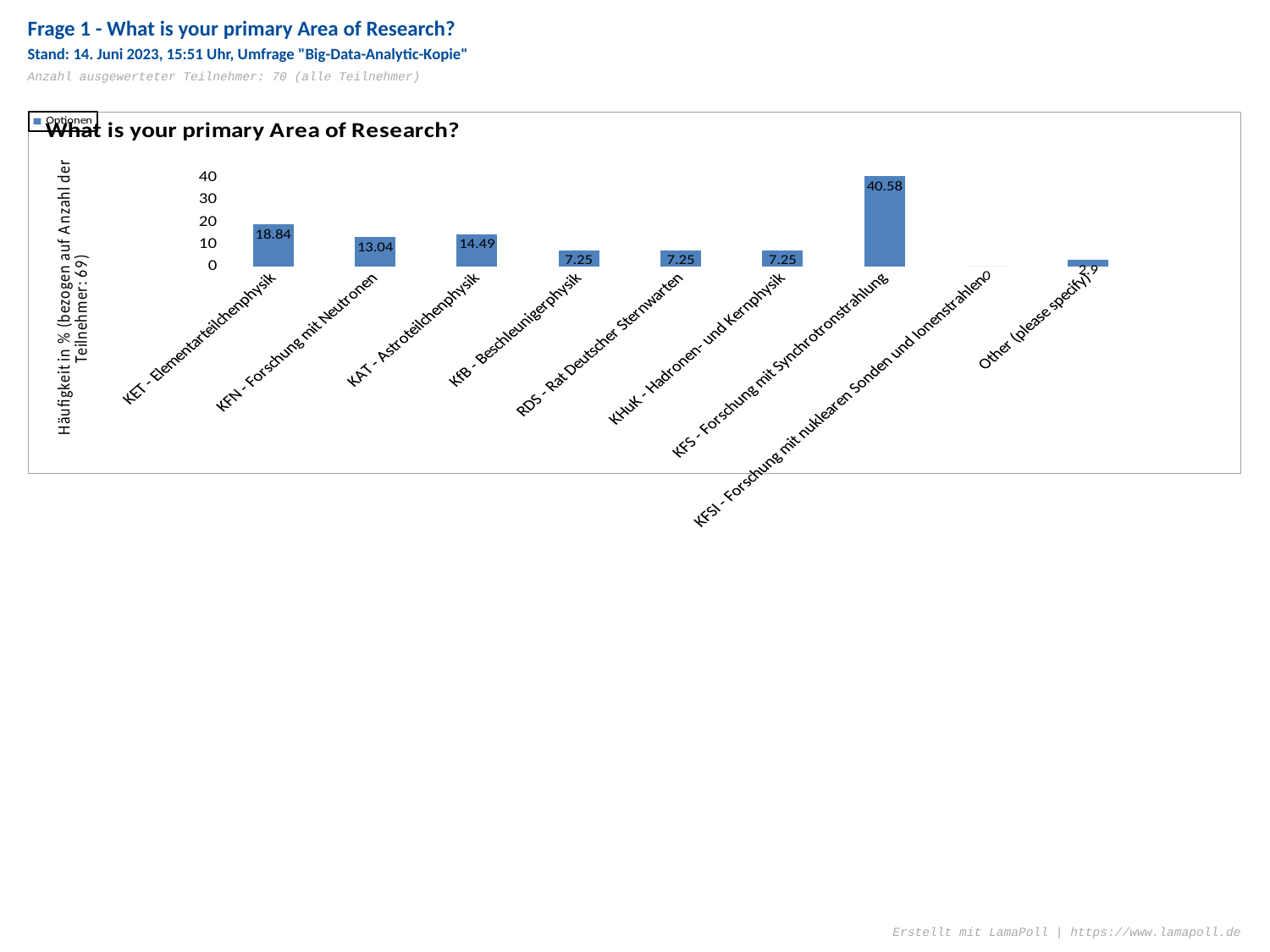
What is the title of the chart? What is your primary Area of Research? What is the value for KFN - Forschung mit Neutronen? 13.04 Which category has the lowest value? KFSI - Forschung mit nuklearen Sonden und Ionenstrahlen Which is larger, the value for KAT - Astroteilchenphysik or KFN - Forschung mit Neutronen? KAT - Astroteilchenphysik What is the difference between the values for KFS - Forschung mit Synchrotronstrahlung and KET - Elementarteilchenphysik? 21.74 What is the value for KFS - Forschung mit Synchrotronstrahlung? 40.58 How many categories are shown on the x axis? 9 Which category has the highest value? KFS - Forschung mit Synchrotronstrahlung What is the value for KAT - Astroteilchenphysik? 14.49 How many series does the legend list? 1 What kind of chart is shown? bar chart What is the value for KET - Elementarteilchenphysik? 18.84